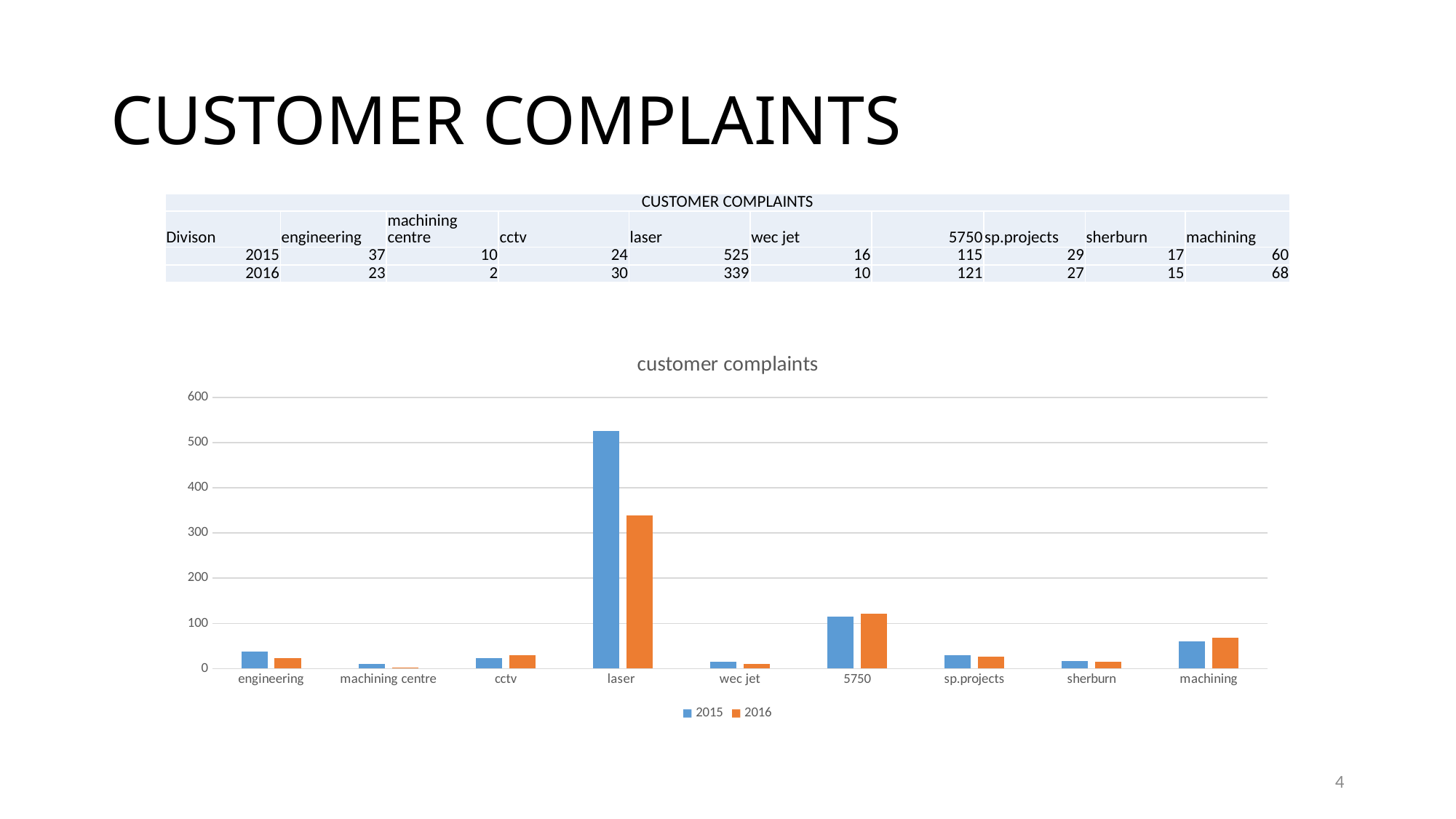
What kind of chart is shown on the slide? bar chart What is the difference between the laser complaints in 2015 and 2016? 186 What is the number of customer complaints for laser in 2015? 525 How many divisions are shown on the x axis of the chart? 9 Which is larger for machining: the 2015 value or the 2016 value? 2016 Is the value for engineering in 2015 greater or less than 100? less What is the title of the chart? customer complaints How many series does the chart legend list? 2 What is the number of customer complaints for 5750 in 2016? 121 Is the value for laser in 2016 greater or less than 300? greater Which division has the lowest number of customer complaints in 2016? machining centre Which division has the highest number of customer complaints in 2015? laser